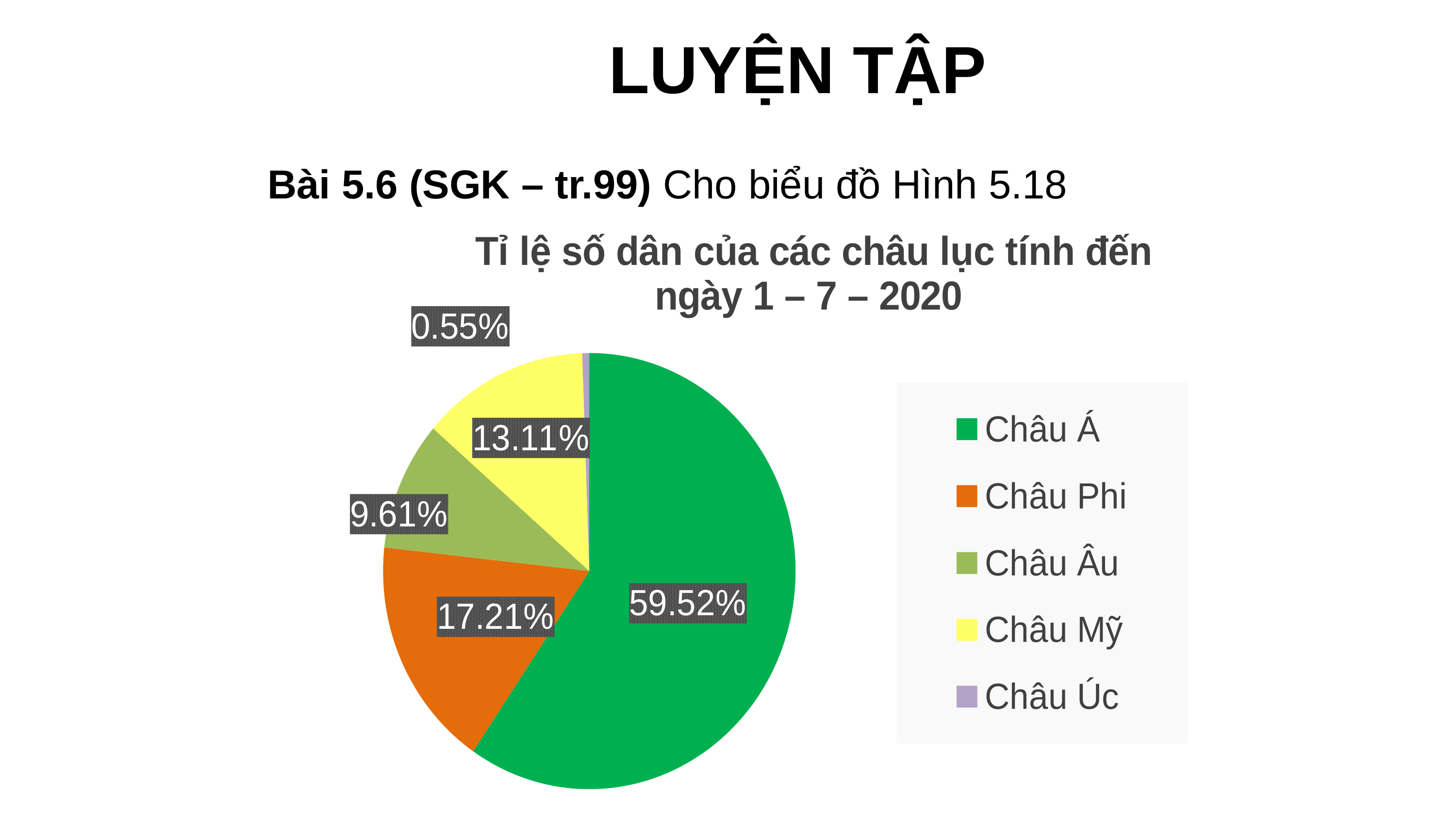
Which continent has the smallest share of the pie chart? Châu Úc What is the value shown for Châu Phi? 17.21% What is the difference in percentage points between Châu Phi and Châu Âu? 7.60% How many continents are shown in the pie chart? 5 What kind of chart is shown on the slide? Pie chart Which is larger, the share for Châu Mỹ or the share for Châu Âu? Châu Mỹ Which continent is represented by the yellow slice? Châu Mỹ What is the value shown for Châu Úc? 0.55% What percentage of the pie chart does Châu Á represent? 59.52% Which continent has the largest share of the pie chart? Châu Á What is the value shown for Châu Mỹ? 13.11% What is the title of the chart? Tỉ lệ số dân của các châu lục tính đến ngày 1 – 7 – 2020